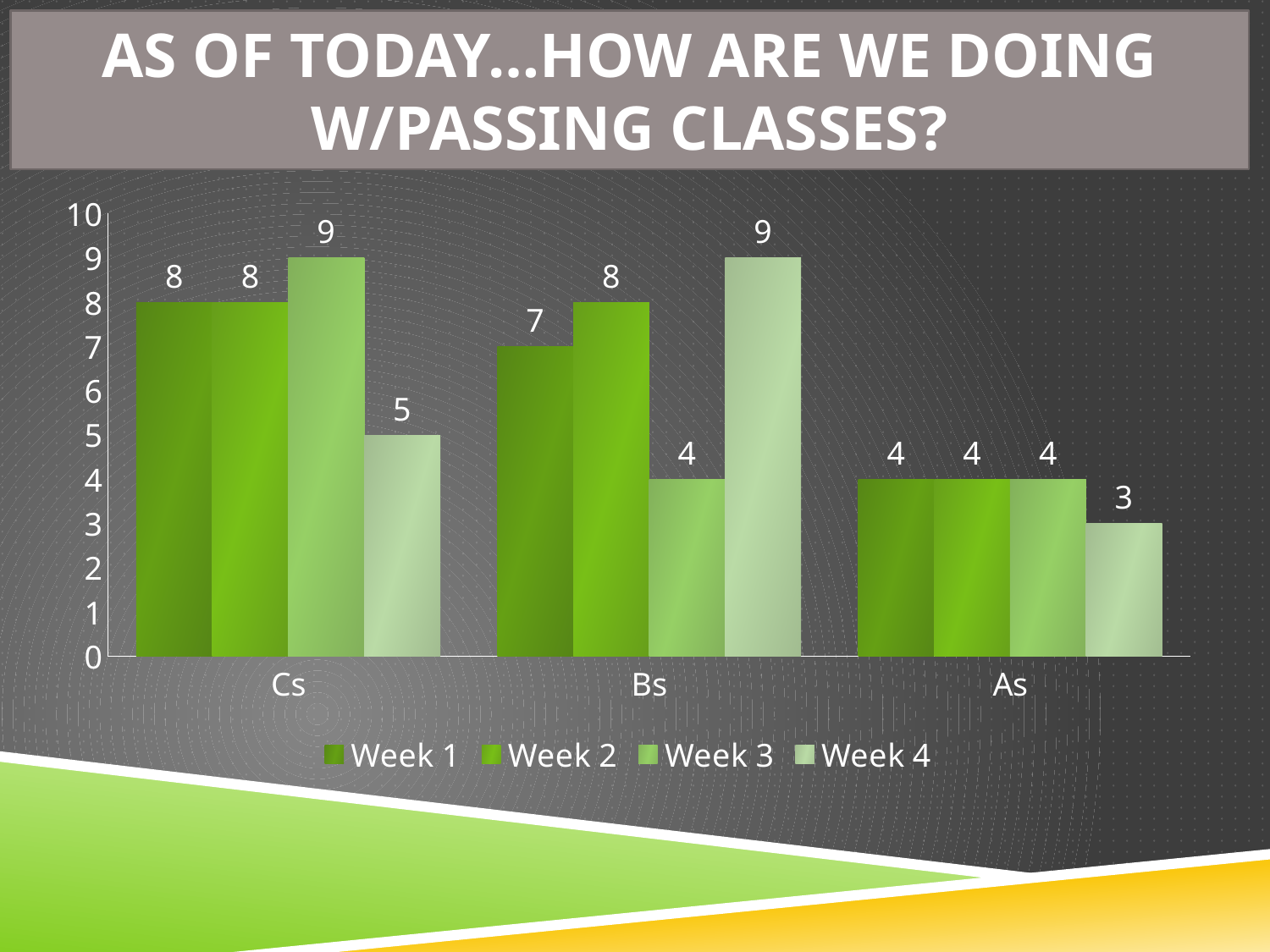
How many categories are shown on the x axis? 3 Which is larger: the Week 4 value for Cs or the Week 4 value for As? Week 4 value for Cs What is the title of the slide? AS OF TODAY…HOW ARE WE DOING W/PASSING CLASSES? What is the value for Week 4 in the As category? 3 What is the difference between the Week 3 and Week 4 values in the Bs category? 5 How many series does the legend list? 4 Which week has the lowest value in the Cs category? Week 4 Which week has the lowest value in the Bs category? Week 3 What kind of chart is shown on the slide? Bar chart What is the value for Week 1 in the Bs category? 7 What is the value for Week 3 in the Cs category? 9 Do the Week 1 values rise or fall from Cs to As along the x axis? Fall